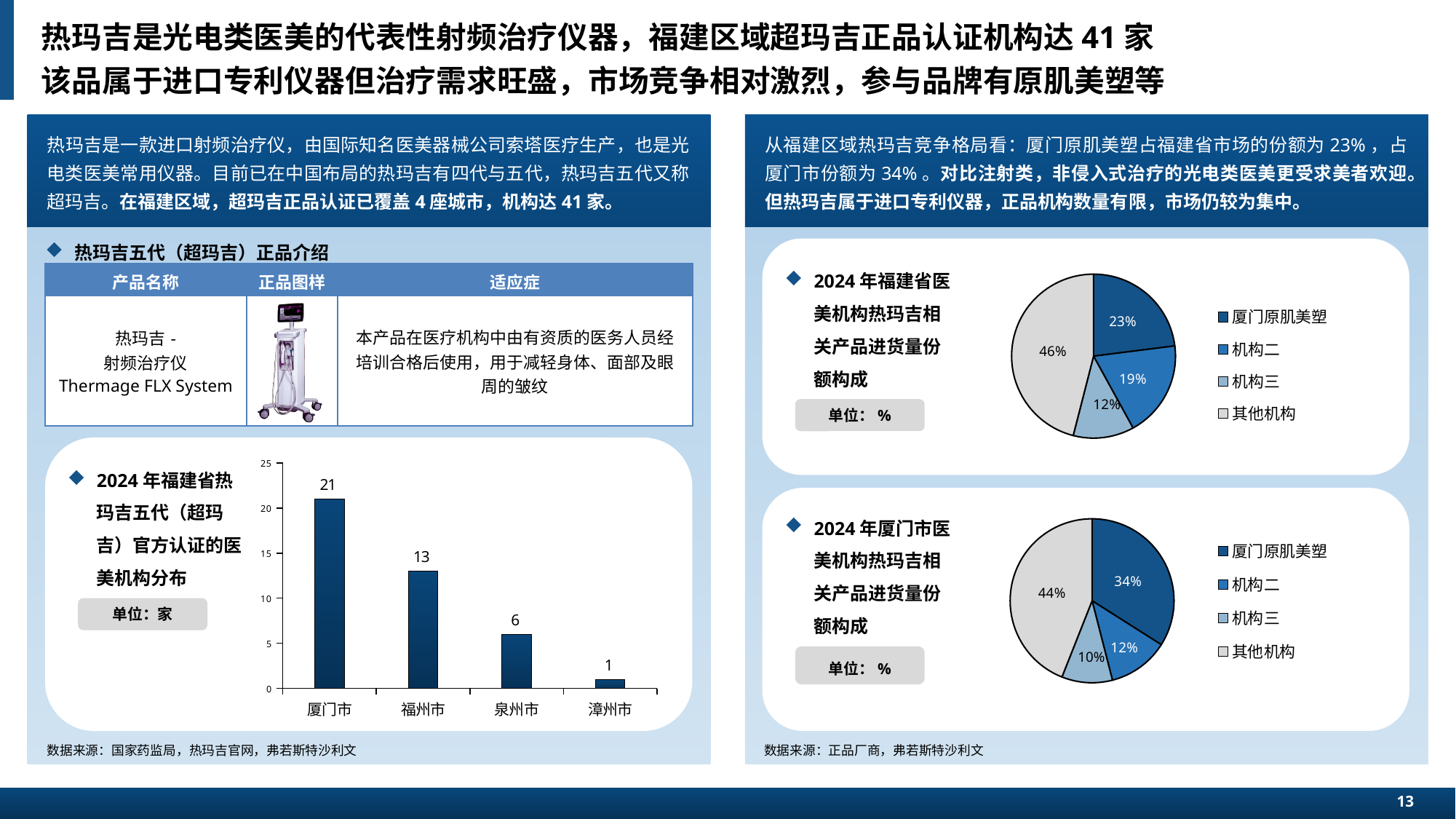
In the top-right pie chart, which category has the largest share? 其他机构 In the bar chart at the bottom left (2024年福建省热玛吉五代（超玛吉）官方认证的医美机构分布), what is the value for 厦门市? 21 In the bar chart at the bottom left, what is the difference between the values for 厦门市 and 福州市? 8 What type of chart is used at the bottom left of the slide? bar chart In the top-right pie chart, what is the difference between the shares of 机构二 and 机构三? 7% In the top-right pie chart (2024年福建省医美机构热玛吉相关产品进货量份额构成), what share does 厦门原肌美塑 hold? 23% In the bar chart at the bottom left, which city has the lowest number of certified institutions? 漳州市 In the bottom-right pie chart, which is larger: the share of 机构二 or 机构三? 机构二 In the bar chart at the bottom left, how many cities are shown? 4 How many entries does the legend of the bottom-right pie chart list? 4 In the bottom-right pie chart (2024年厦门市医美机构热玛吉相关产品进货量份额构成), what share does 厦门原肌美塑 hold? 34% In the bar chart at the bottom left, do the values rise or fall from 厦门市 to 漳州市? fall